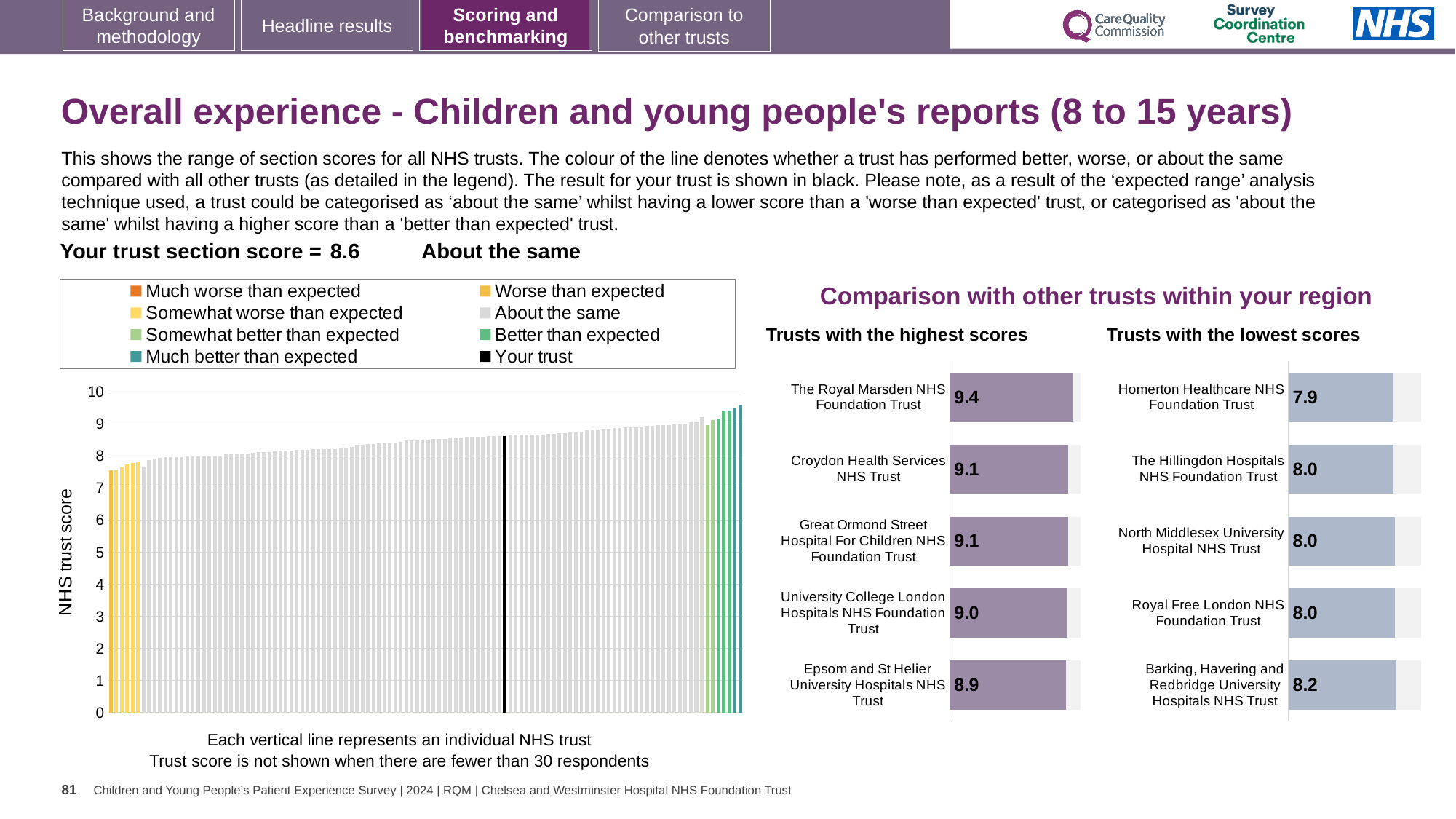
On the main chart on the left, what is the section score for your trust (the black bar)? 8.6 On the 'Trusts with the lowest scores' chart, what is the score for Homerton Healthcare NHS Foundation Trust? 7.9 On the 'Trusts with the highest scores' chart, what is the difference between the scores of The Royal Marsden NHS Foundation Trust and Epsom and St Helier University Hospitals NHS Trust? 0.5 On the 'Trusts with the highest scores' chart, which trust has the lowest score shown? Epsom and St Helier University Hospitals NHS Trust How many entries does the legend of the main chart on the left list? 8 On the 'Trusts with the highest scores' chart, what is the score for The Royal Marsden NHS Foundation Trust? 9.4 On the main chart on the left, do the trust scores rise or fall from left to right? rise On the 'Trusts with the lowest scores' chart, which trust has the highest score shown? Barking, Havering and Redbridge University Hospitals NHS Trust On the main chart on the left, is the value for the black 'Your trust' bar greater or less than 8? greater Which is larger: the score for Croydon Health Services NHS Trust on the highest scores chart or the score for Royal Free London NHS Foundation Trust on the lowest scores chart? Croydon Health Services NHS Trust How many trusts are listed on the 'Trusts with the highest scores' chart? 5 On the 'Trusts with the lowest scores' chart, what is the difference between the scores of Barking, Havering and Redbridge University Hospitals NHS Trust and Homerton Healthcare NHS Foundation Trust? 0.3